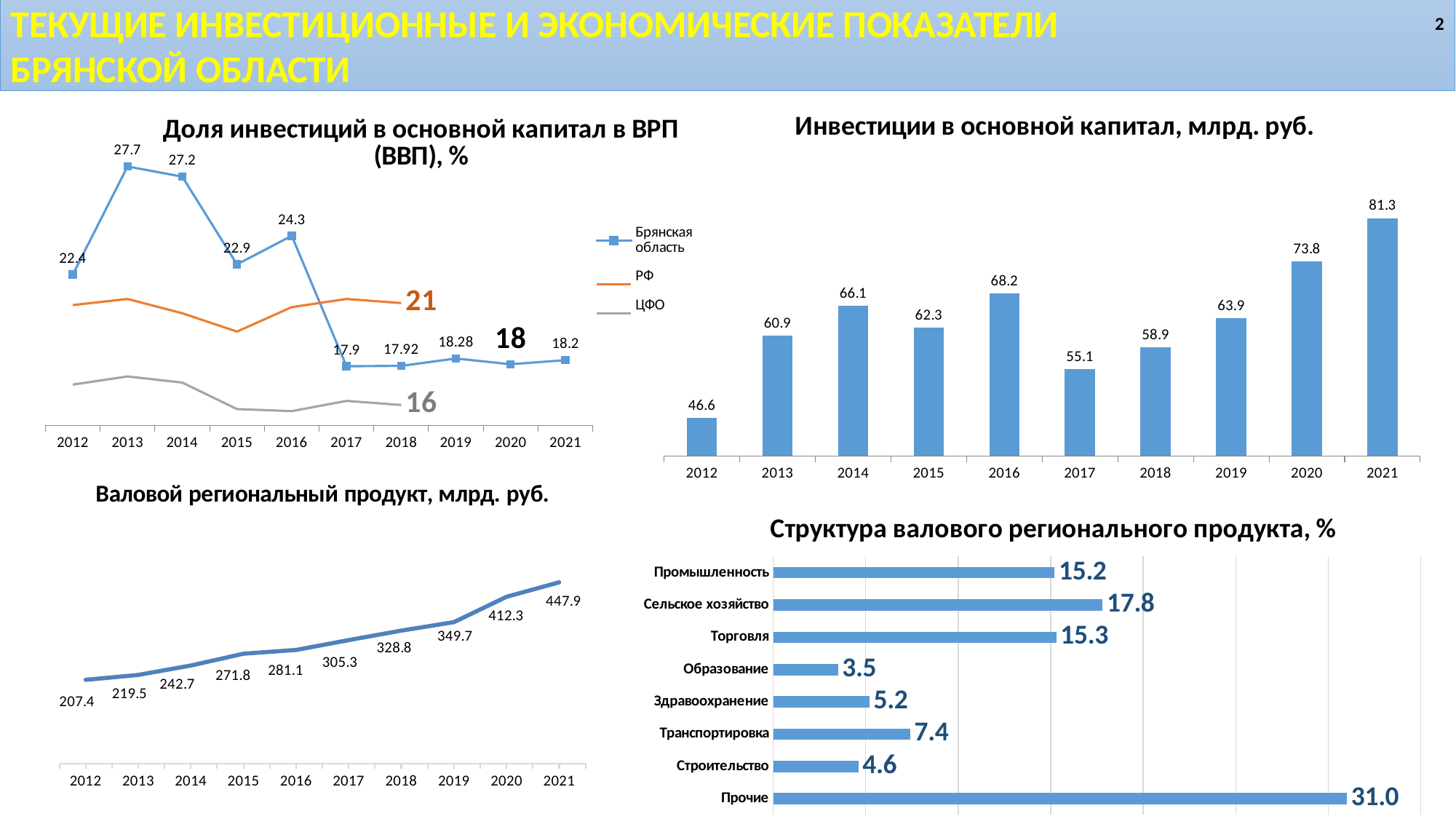
In the chart 'Структура валового регионального продукта, %', what is the value for Сельское хозяйство? 17.8 In the chart 'Структура валового регионального продукта, %', which category has the highest value? Прочие What kind of chart is 'Валовой региональный продукт, млрд. руб.'? Line chart In the chart 'Доля инвестиций в основной капитал в ВРП (ВВП), %', what is the value for Брянская область in 2013? 27.7 In the chart 'Инвестиции в основной капитал, млрд. руб.', what is the value for 2021? 81.3 In the chart 'Инвестиции в основной капитал, млрд. руб.', what is the difference between the values for 2021 and 2020? 7.5 In the chart 'Инвестиции в основной капитал, млрд. руб.', how many years are shown on the x axis? 10 In the chart 'Инвестиции в основной капитал, млрд. руб.', which year has the lowest value? 2012 In the chart 'Валовой региональный продукт, млрд. руб.', do the values rise or fall from 2012 to 2021? Rise In the chart 'Валовой региональный продукт, млрд. руб.', what is the value for 2019? 349.7 In the chart 'Доля инвестиций в основной капитал в ВРП (ВВП), %', how many series does the legend list? 3